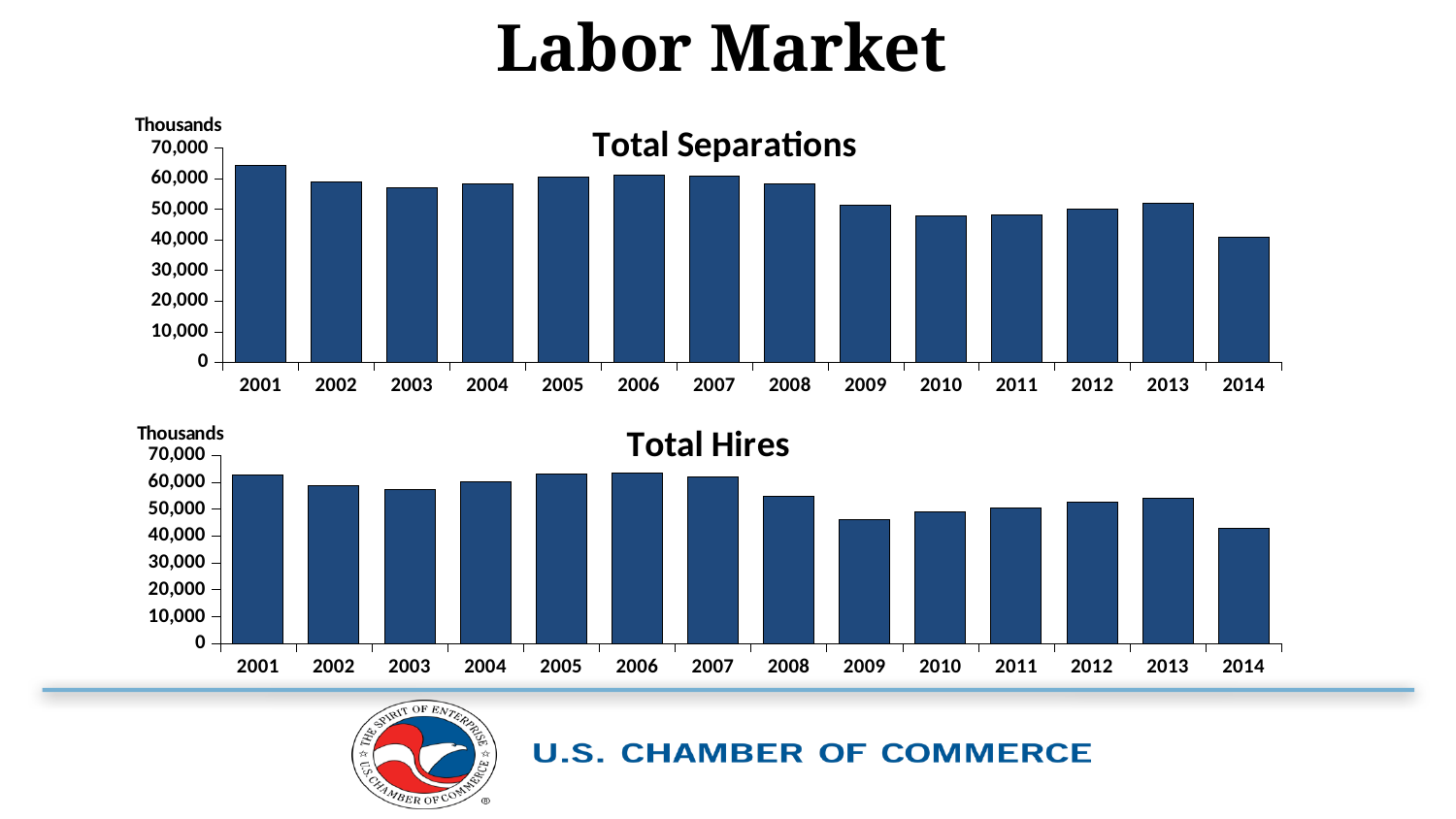
What unit is shown above the y axis of the Total Separations chart? Thousands In the Total Hires chart, is the value for 2009 greater or less than 50,000? less In the Total Hires chart, which year has the highest value? 2006 In the Total Hires chart, is the value for 2006 greater or less than 60,000? greater In the Total Hires chart, do the values rise or fall from 2006 to 2009? fall In the Total Separations chart, which year has the highest value? 2001 In the Total Separations chart, is the value for 2014 greater or less than 50,000? less In the Total Hires chart, which year has the lowest value? 2014 In the Total Separations chart, which year has the lowest value? 2014 How many years are shown on the x axis of the Total Hires chart? 14 In the Total Separations chart, which is larger, the value for 2001 or the value for 2014? 2001 What kind of chart is the Total Separations chart? bar chart